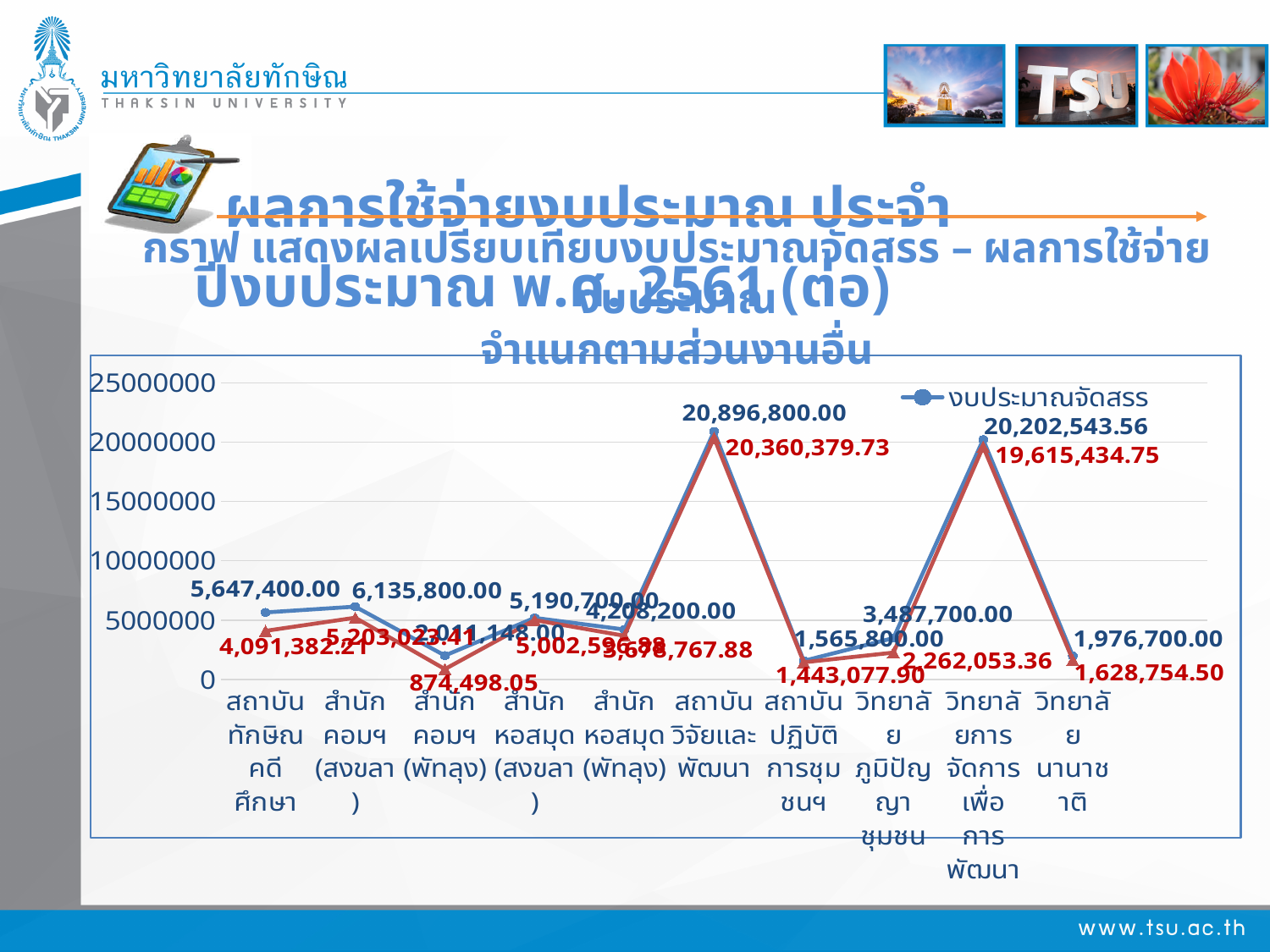
What is the งบประมาณจัดสรร value for วิทยาลัยนานาชาติ? 1,976,700.00 What series name is shown in the chart legend? งบประมาณจัดสรร Which unit has the lowest red-series value? สำนักคอมฯ (พัทลุง) What is the งบประมาณจัดสรร value for สถาบันวิจัยและพัฒนา? 20,896,800.00 Which has the larger งบประมาณจัดสรร value: สำนักคอมฯ (สงขลา) or สถาบันทักษิณคดีศึกษา? สำนักคอมฯ (สงขลา) What is the difference between the two values shown for วิทยาลัยการจัดการเพื่อการพัฒนา (20,202,543.56 and 19,615,434.75)? 587,108.81 What kind of chart is shown on the slide? line chart What is the red-series value for วิทยาลัยการจัดการเพื่อการพัฒนา? 19,615,434.75 Which unit has the highest งบประมาณจัดสรร value? สถาบันวิจัยและพัฒนา How many units (categories) are shown on the x axis of the chart? 10 Is the งบประมาณจัดสรร value for สถาบันวิจัยและพัฒนา greater or less than 20000000? greater What is the difference between the two values shown for สถาบันวิจัยและพัฒนา (20,896,800.00 and 20,360,379.73)? 536,420.27